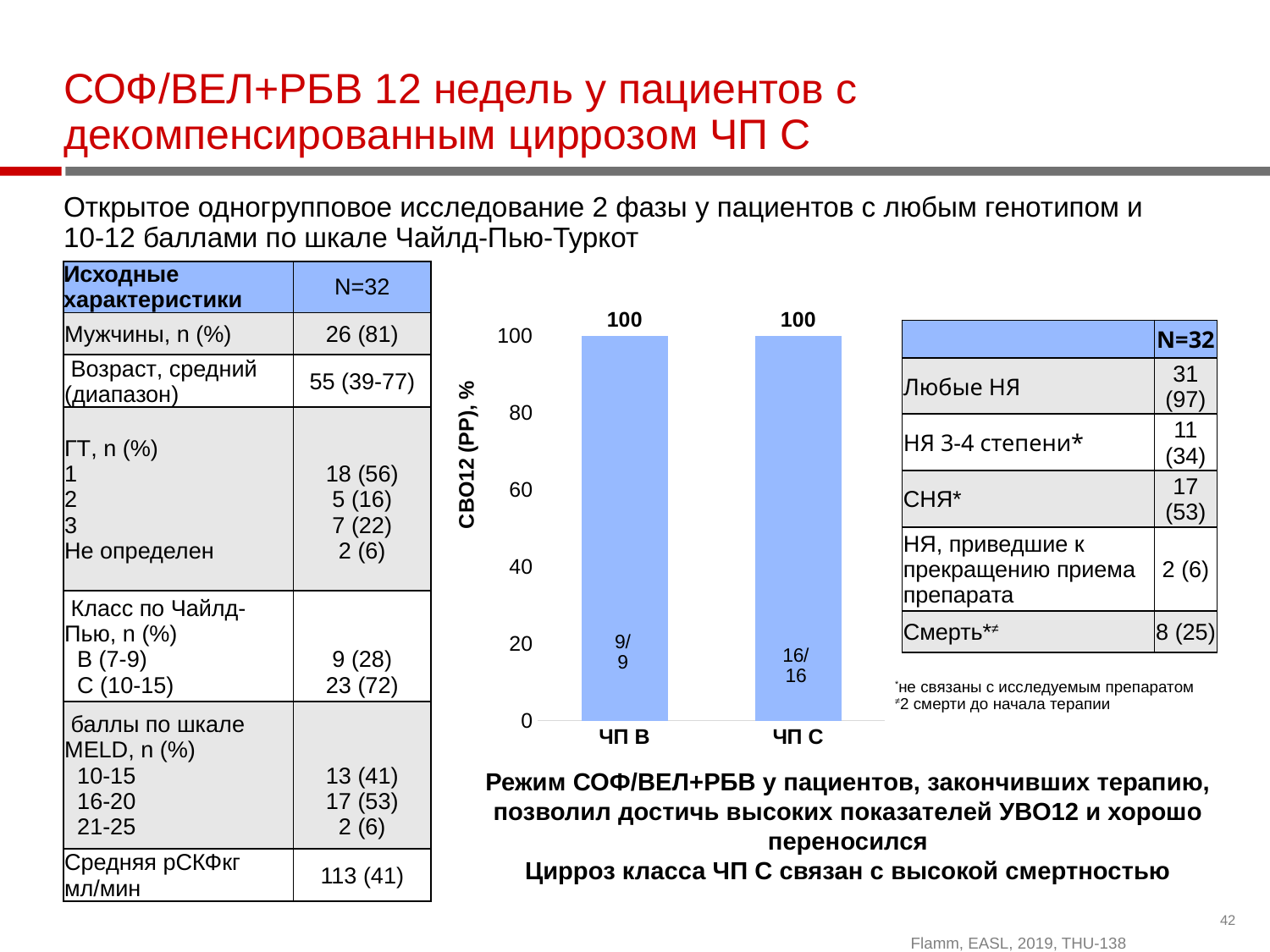
What fraction of patients is shown inside the ЧП B bar? 9/9 Is the value for ЧП C greater or less than 80? greater What is the highest tick value shown on the y axis of the chart? 100 What is the СВО12 (PP), % value for ЧП C? 100 What is the label of the y axis of the chart? СВО12 (PP), % What is the СВО12 (PP), % value for ЧП B? 100 What kind of chart is shown on the slide? bar chart How many categories are shown on the x axis of the chart? 2 What fraction of patients is shown inside the ЧП C bar? 16/16 Is the value for ЧП B greater or less than 60? greater What is the difference between the СВО12 values for ЧП B and ЧП C? 0